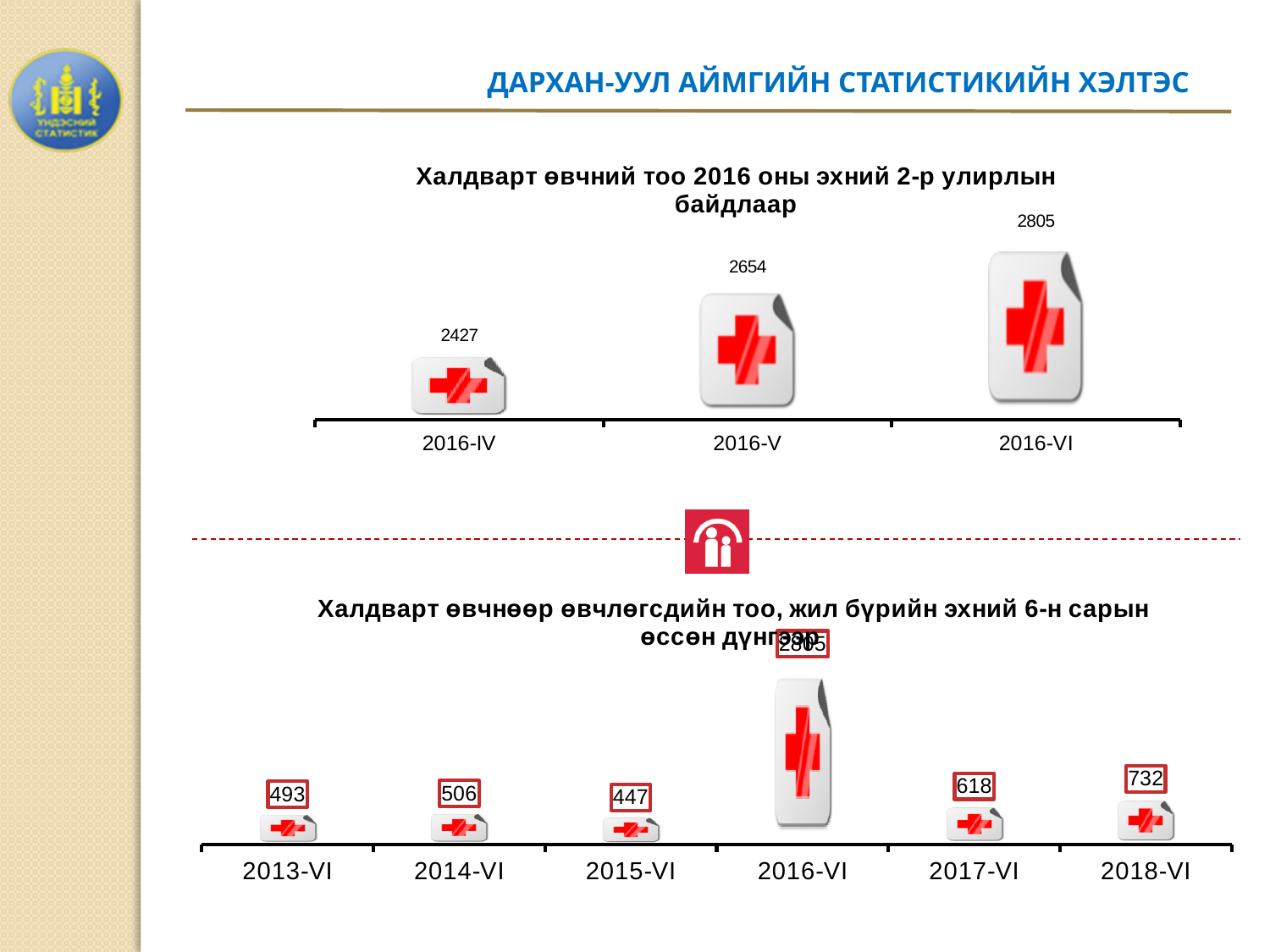
In the bottom chart, how many categories are shown on the x axis? 6 In the top chart, what is the difference between the values for 2016-VI and 2016-IV? 378 In the bottom chart, which category has the lowest value? 2015-VI In the top chart, which category has the highest value? 2016-VI In the bottom chart, what is the value for 2018-VI? 732 In the top chart, how many categories are shown on the x axis? 3 In the bottom chart, what is the value for 2015-VI? 447 In the bottom chart, what is the difference between the values for 2018-VI and 2017-VI? 114 In the top chart, do the values rise or fall from 2016-IV to 2016-VI? rise In the top chart, what is the value for 2016-V? 2654 In the bottom chart, which is larger, the value for 2017-VI or the value for 2014-VI? 2017-VI In the top chart, what is the value for 2016-IV? 2427